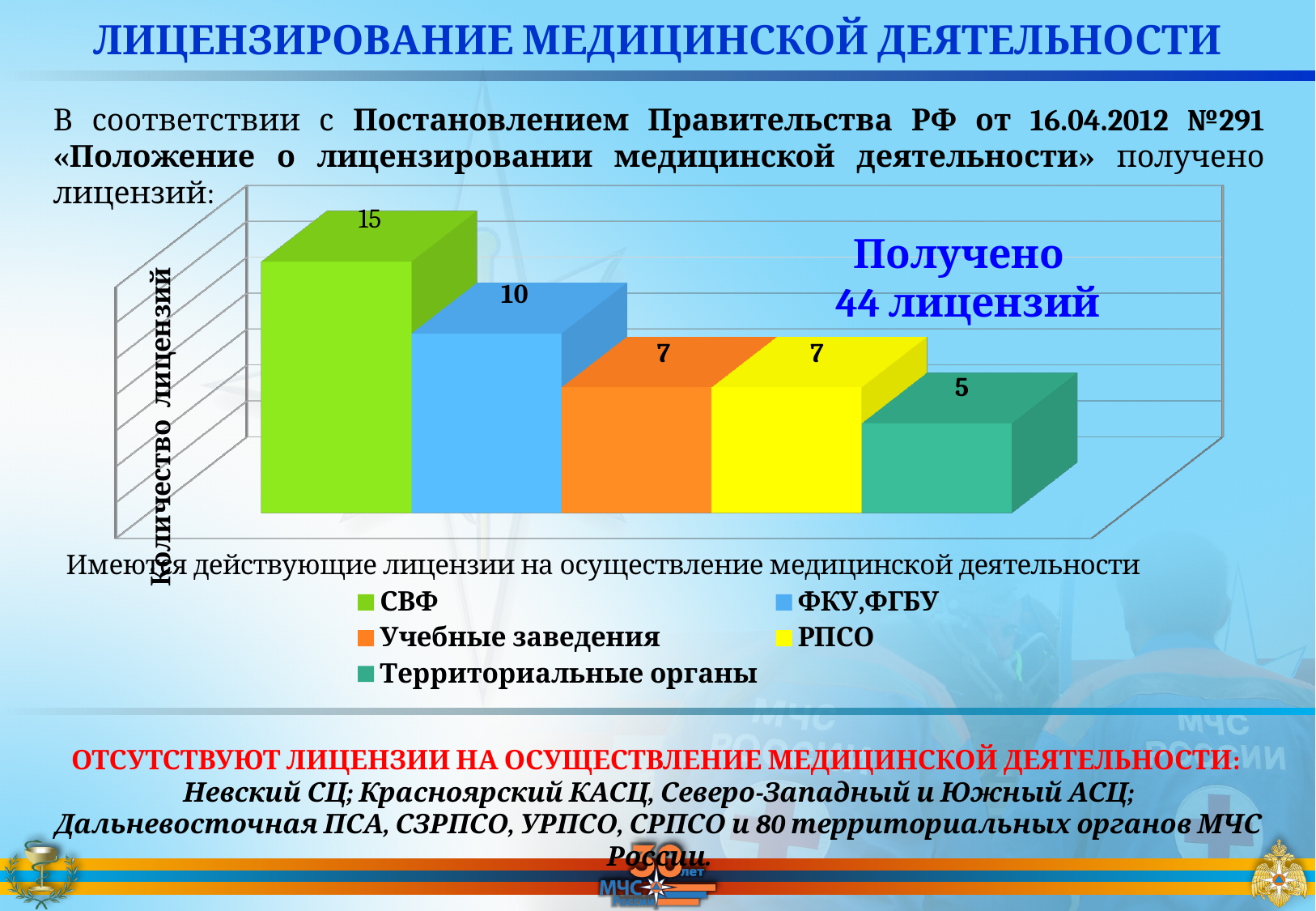
What is the label of the vertical axis of the chart? Количество лицензий What value is shown for ФКУ,ФГБУ? 10 Which is larger, the value for ФКУ,ФГБУ or the value for Учебные заведения? ФКУ,ФГБУ What kind of chart is shown on the slide? Bar chart What value is shown for Территориальные органы? 5 What value is shown for РПСО? 7 How many entries does the legend list? 5 How many categories (bars) are plotted in the chart? 5 Which category has the highest number of licenses? СВФ What is the difference between the values for СВФ and ФКУ,ФГБУ? 5 Which category has the lowest number of licenses? Территориальные органы How many licenses does the chart show for СВФ? 15